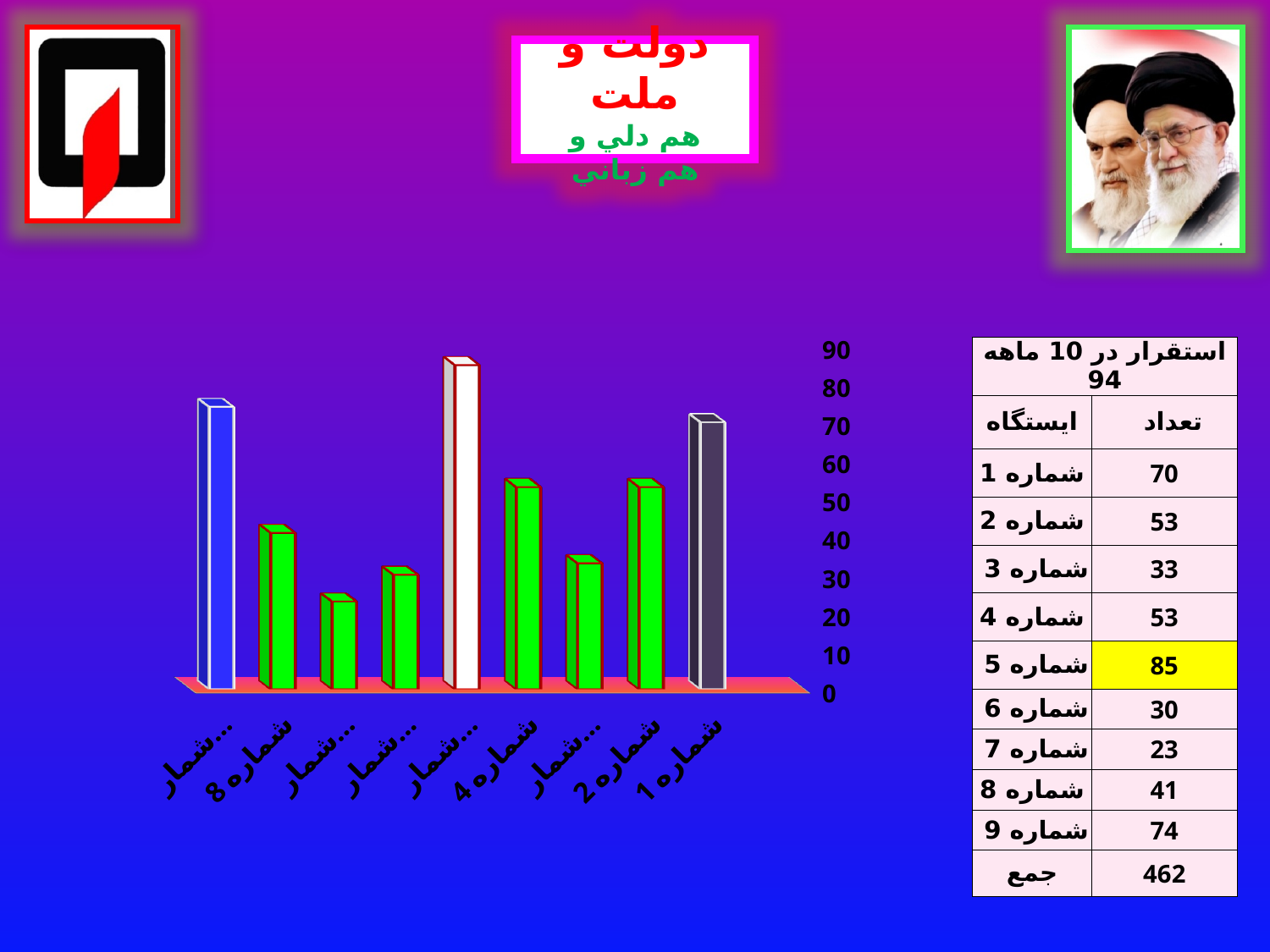
Which station has the highest bar in the chart? شماره 5 Is the value for شماره 8 greater or less than 50? less Is the value for شماره 2 greater or less than 60? less How many bars are plotted in the chart? 9 What kind of chart is shown on the slide? bar chart According to the table next to the chart, what is the total (جمع) of all stations? 462 Is the value for شماره 4 greater or less than 40? greater According to the table next to the chart, what is the value (تعداد) for شماره 5? 85 What colour is the tallest bar in the chart? white Which is larger, the bar for شماره 1 or the bar for شماره 8? شماره 1 Which station has the lowest bar in the chart? شماره 7